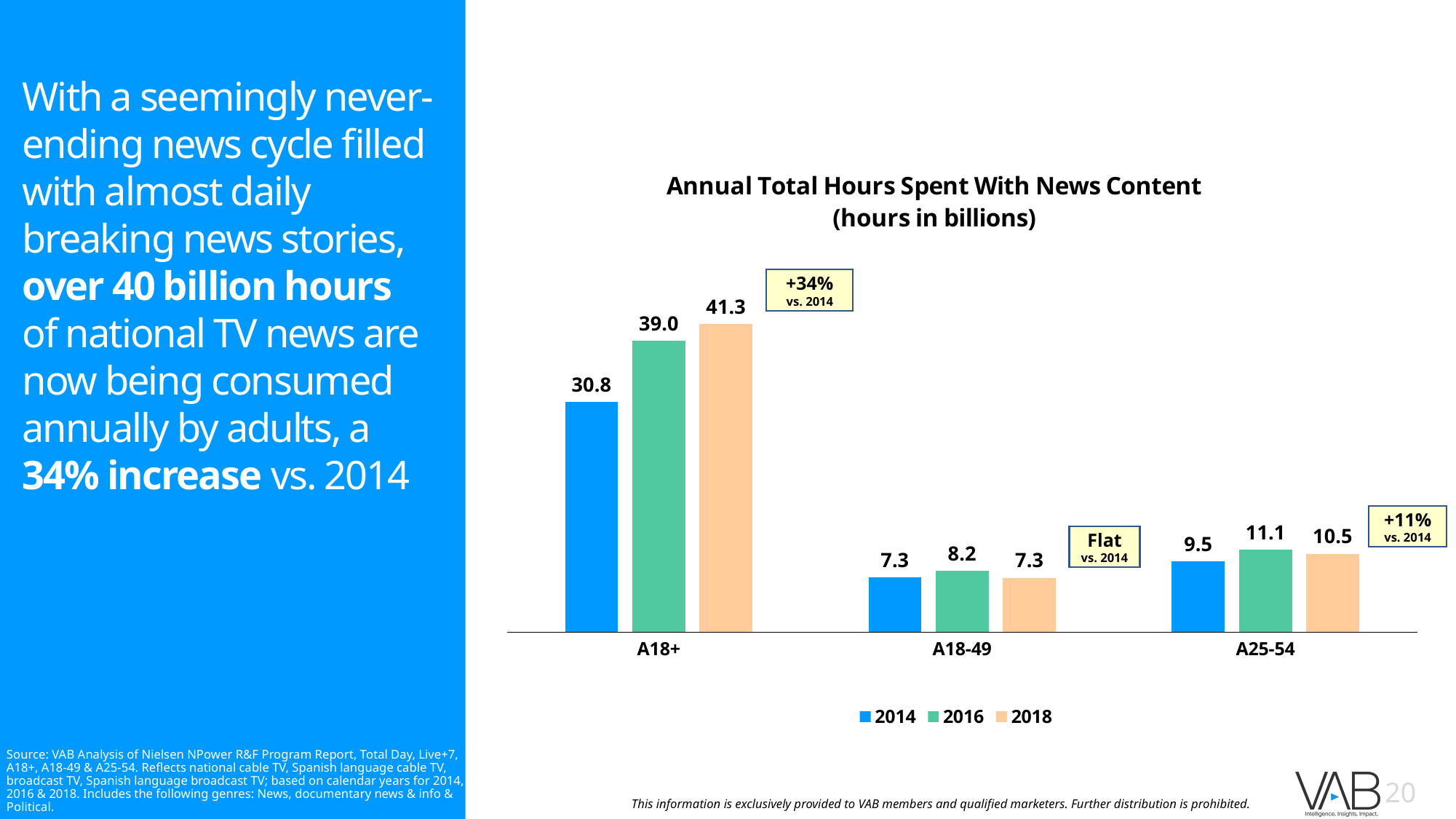
What is the value for A18+ in 2018? 41.3 How many categories are shown on the x axis? 3 What is the difference between the 2018 and 2014 values for A18+? 10.5 Which category has the highest value in 2014? A18+ Which is larger for A25-54: the 2016 value or the 2018 value? 2016 What is the value for A25-54 in 2014? 9.5 Do the values for A18+ rise or fall from 2014 to 2018? Rise What is the title of the chart? Annual Total Hours Spent With News Content (hours in billions) Which category has the lowest value in 2018? A18-49 How many series does the legend list? 3 What kind of chart is shown? Bar chart What is the value for A18-49 in 2016? 8.2